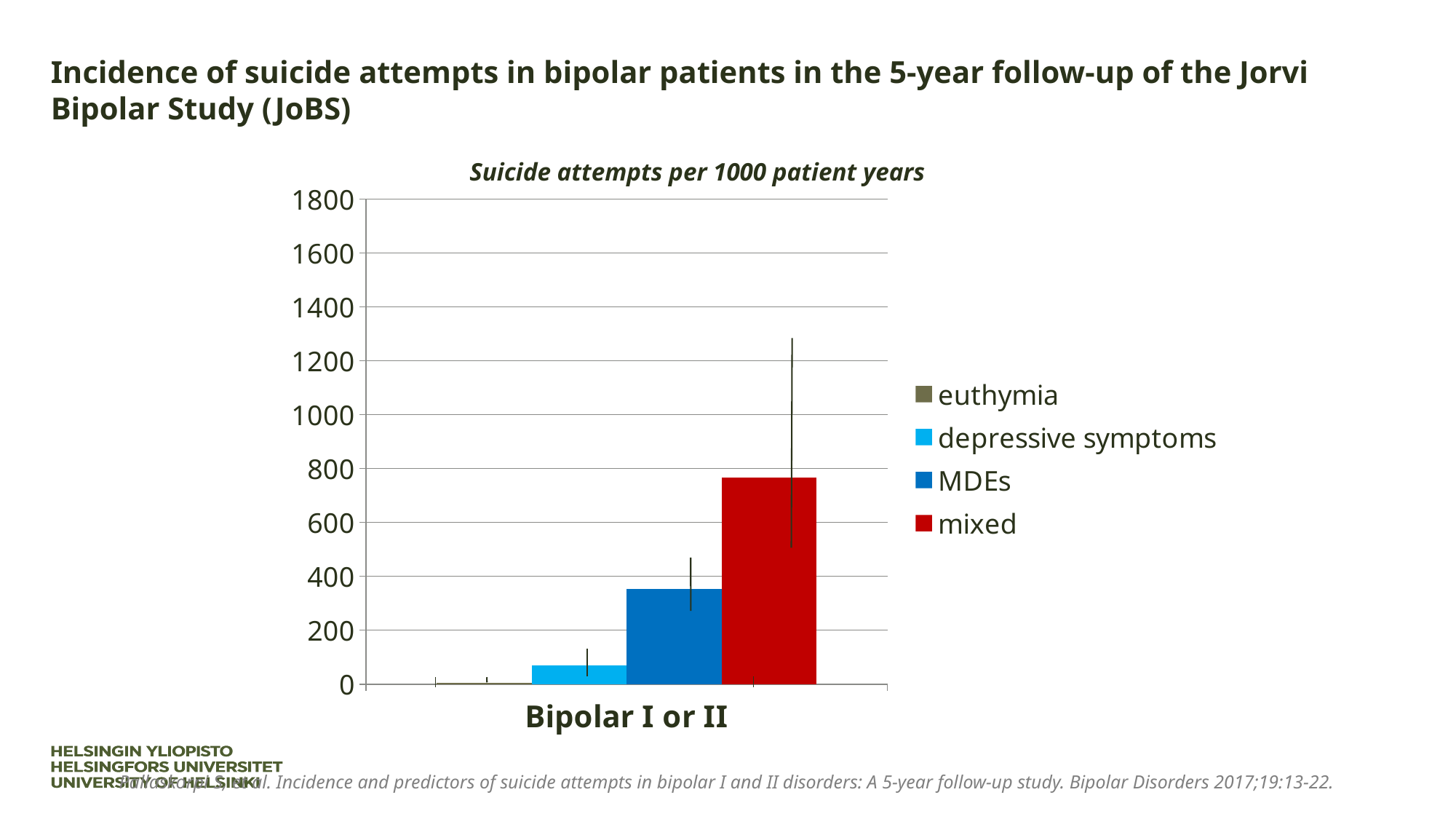
Which is larger, the value for MDEs or the value for depressive symptoms? MDEs Is the value for depressive symptoms greater or less than 200? less How many categories are shown on the x axis? 1 Which is larger, the value for mixed or the value for MDEs? mixed Is the value for MDEs greater or less than 400? less Is the value for mixed greater or less than 600? greater What is the label of the category on the x axis? Bipolar I or II How many series does the legend list? 4 Which series has the lowest value for Bipolar I or II? euthymia What kind of chart is shown on the slide? bar chart Which series has the highest value for Bipolar I or II? mixed What is the title of the chart? Suicide attempts per 1000 patient years